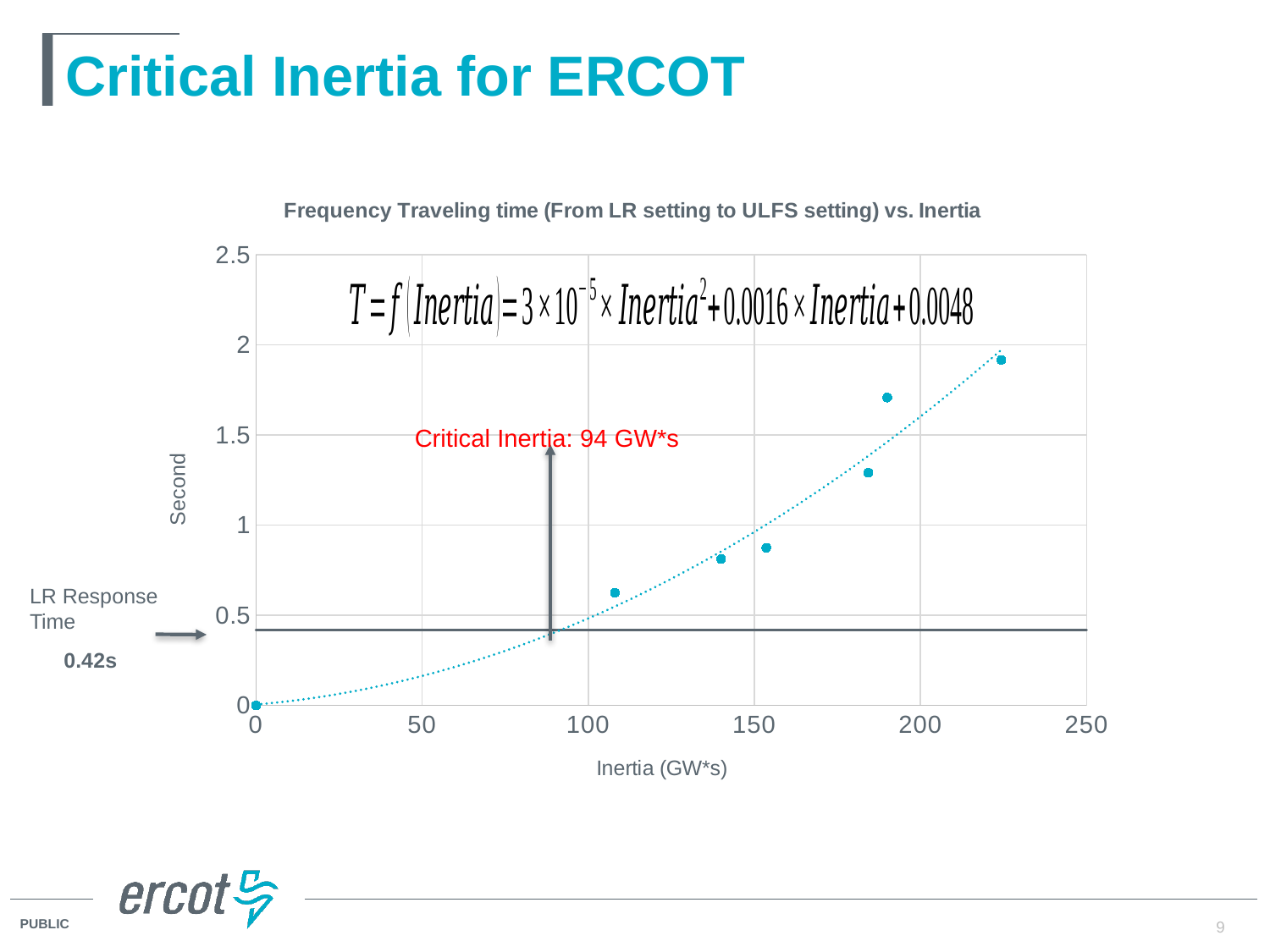
What is the maximum value shown on the y axis of the chart? 2.5 Is the value for the data point with the highest inertia (near 225 GW*s) greater or less than 1.5 seconds? greater What is the label of the x axis of the chart? Inertia (GW*s) Which data point has the highest frequency traveling time: the one near 190 GW*s or the one near 225 GW*s? The one near 225 GW*s What LR Response Time is marked by the horizontal line on the chart? 0.42s Do the plotted values rise or fall as inertia increases along the x axis? Rise How many data points are plotted on the chart? 7 What is the title of the chart? Frequency Traveling time (From LR setting to ULFS setting) vs. Inertia Is the value for the data point near 190 GW*s inertia greater or less than 1.5 seconds? greater What kind of chart is shown on the slide? Scatter chart Is the value for the data point near 108 GW*s inertia greater or less than 1 second? less What critical inertia value is annotated on the chart? 94 GW*s